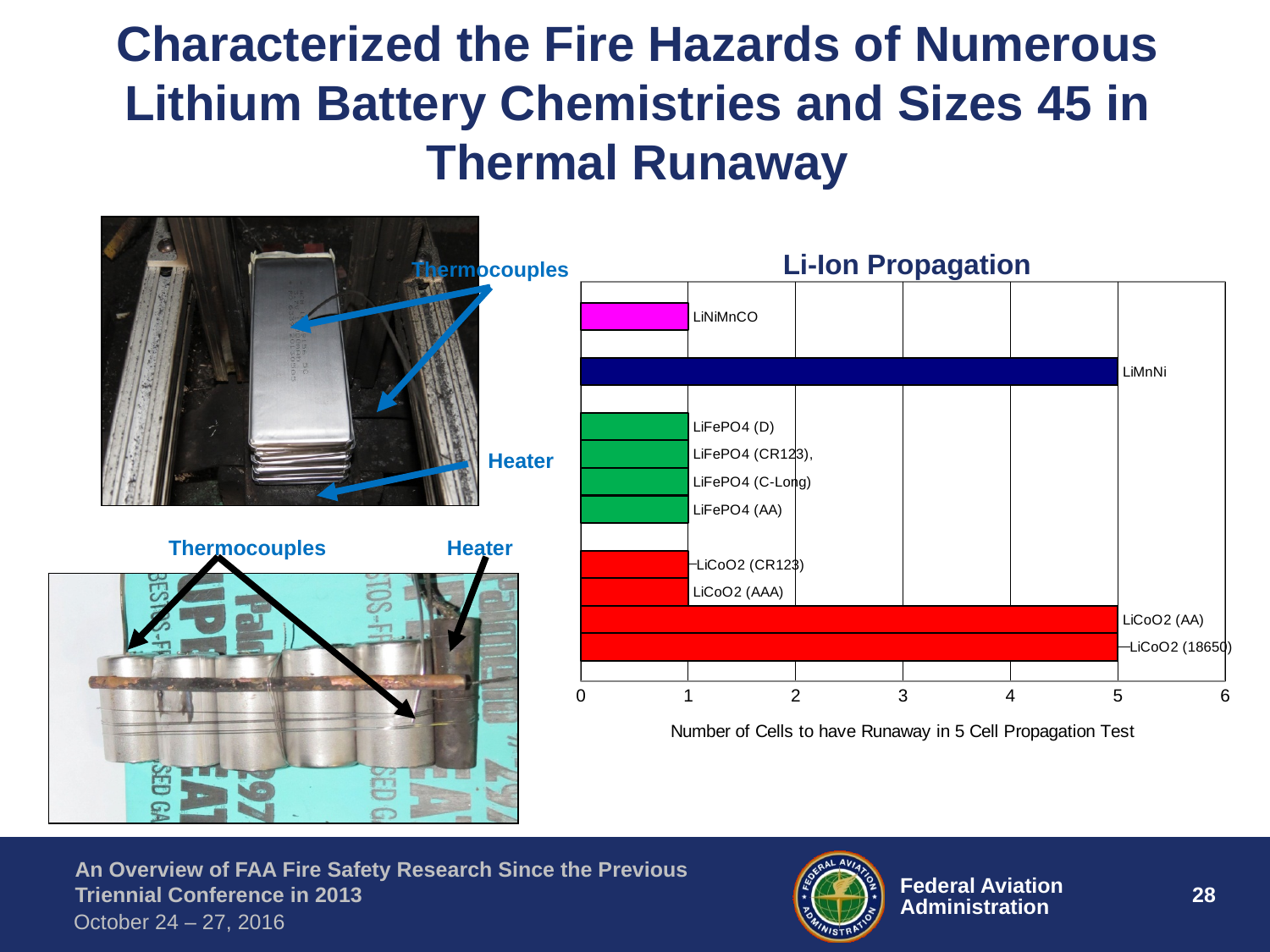
What is the difference between the values for LiCoO2 (AA) and LiCoO2 (AAA)? 4 How many cells had runaway for LiCoO2 (AA)? 5 How many battery types (bars) are plotted in the chart? 10 How many cells had runaway for LiFePO4 (D)? 1 How many cells had runaway for LiCoO2 (AAA)? 1 What type of chart is shown on the slide? Bar chart How many cells had runaway for LiMnNi? 5 What is the x-axis label of the chart? Number of Cells to have Runaway in 5 Cell Propagation Test Is the value for LiCoO2 (18650) greater or less than 4? greater Is the value for LiFePO4 (AA) greater or less than 2? less What is the title of the chart? Li-Ion Propagation Which has a larger value, LiMnNi or LiNiMnCO? LiMnNi